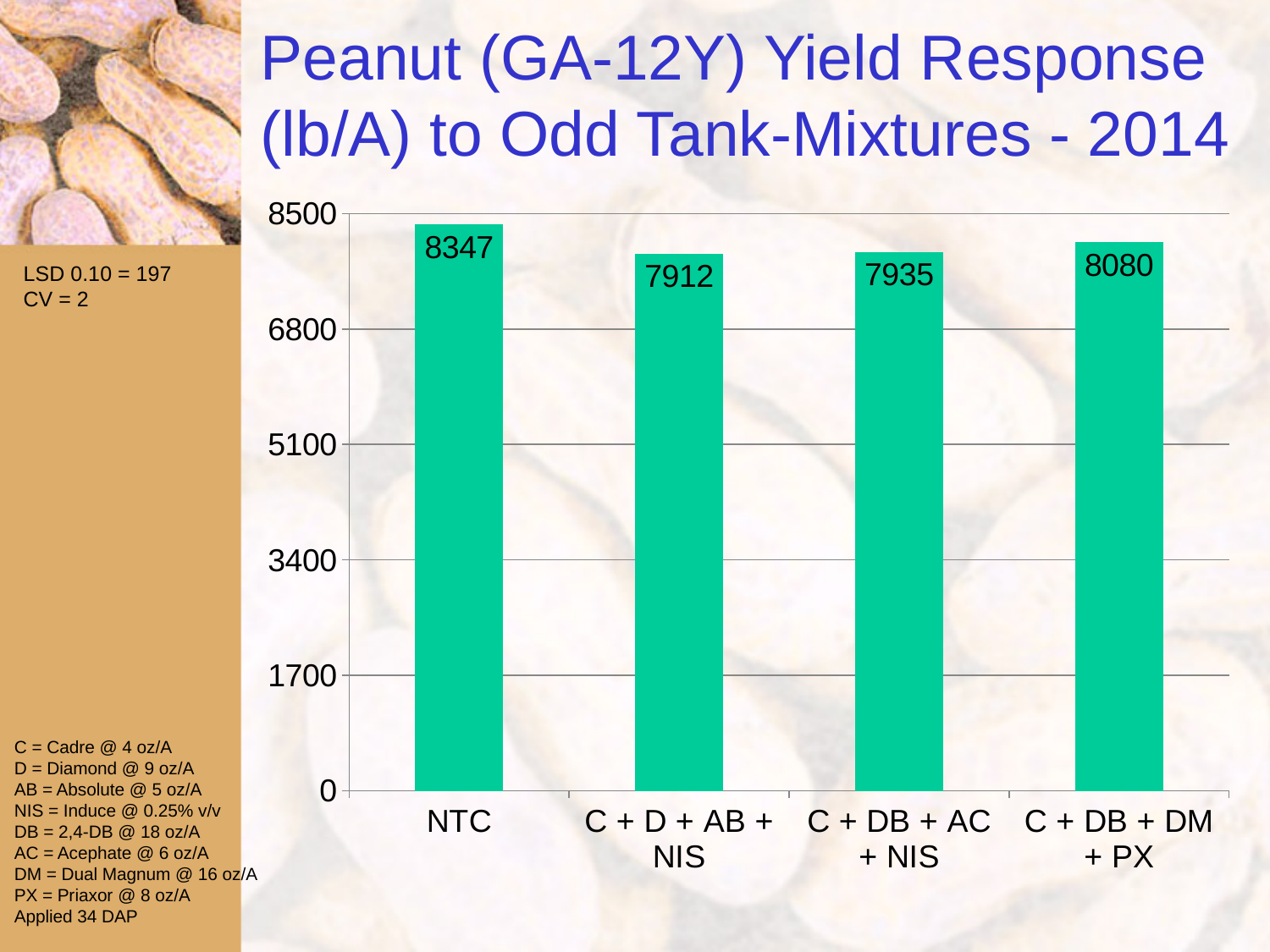
What is the yield value for NTC? 8347 What is the yield value for C + DB + DM + PX? 8080 What kind of chart is shown on the slide? Bar chart Which has a higher yield, NTC or C + DB + DM + PX? NTC Which treatment has the highest yield? NTC What is the title of the chart? Peanut (GA-12Y) Yield Response (lb/A) to Odd Tank-Mixtures - 2014 What is the yield value for C + DB + AC + NIS? 7935 What is the difference in yield between C + DB + AC + NIS and C + D + AB + NIS? 23 What is the difference in yield between NTC and C + DB + DM + PX? 267 How many treatments are shown in the chart? 4 Which treatment has the lowest yield? C + D + AB + NIS What is the yield value for C + D + AB + NIS? 7912